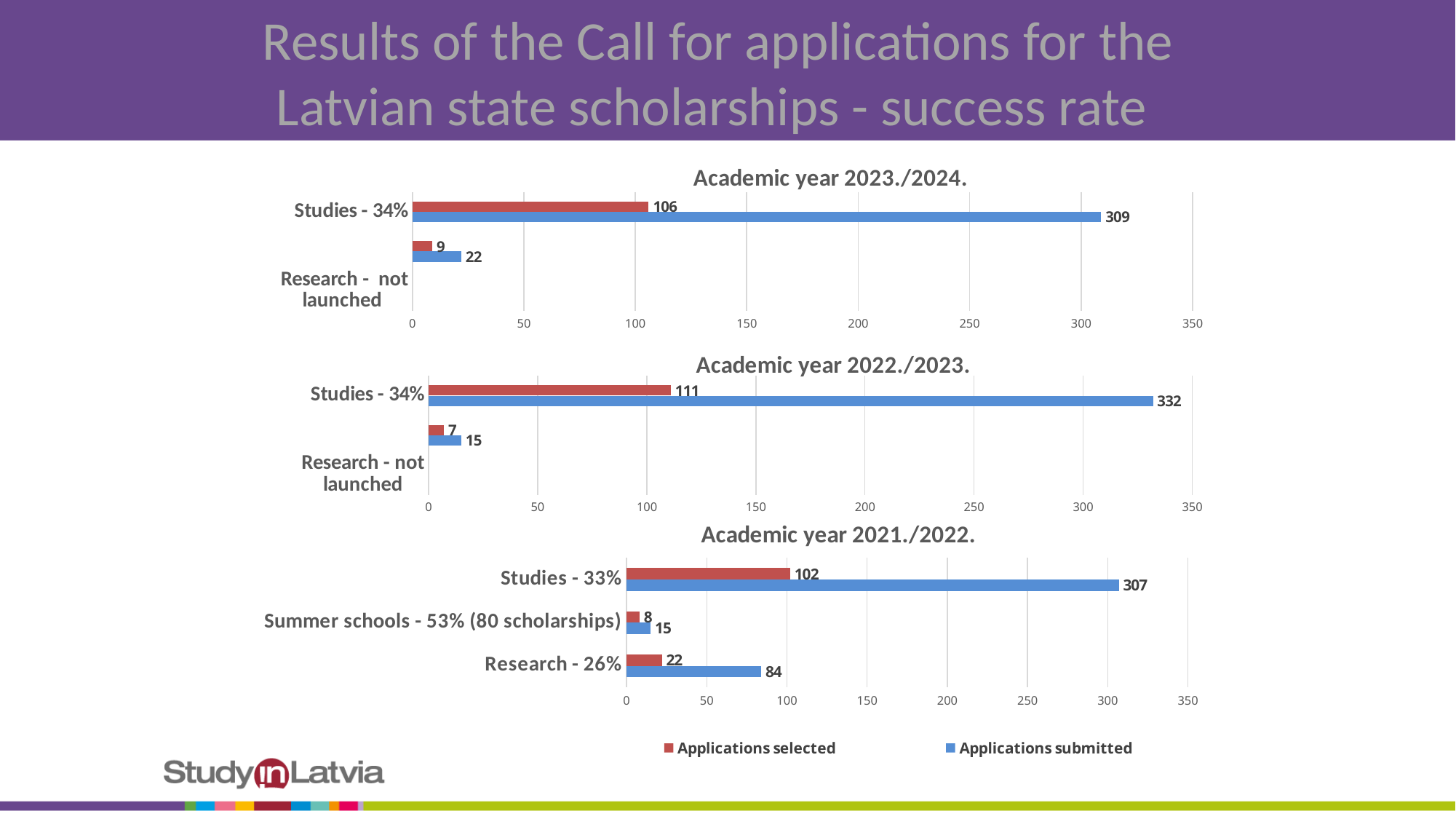
How many series does the legend list for the charts on the slide? 2 In the 'Academic year 2021./2022.' chart, how many categories are shown? 3 Which colour represents 'Applications submitted' in the charts? blue In the 'Academic year 2023./2024.' chart, how many applications were submitted for 'Studies - 34%'? 309 In the 'Academic year 2021./2022.' chart, which category has the lowest number of applications submitted? Summer schools - 53% (80 scholarships) In the 'Academic year 2021./2022.' chart, is the number of applications submitted for 'Studies - 33%' greater or less than 300? greater In the 'Academic year 2022./2023.' chart, what is the difference between applications submitted and applications selected for 'Studies - 34%'? 221 Which is larger: applications submitted for Studies in the 'Academic year 2022./2023.' chart or in the 'Academic year 2023./2024.' chart? Academic year 2022./2023. In the 'Academic year 2021./2022.' chart, how many applications were submitted for 'Research - 26%'? 84 In the 'Academic year 2022./2023.' chart, how many applications were selected for 'Studies - 34%'? 111 What type of chart is the 'Academic year 2023./2024.' chart? bar chart